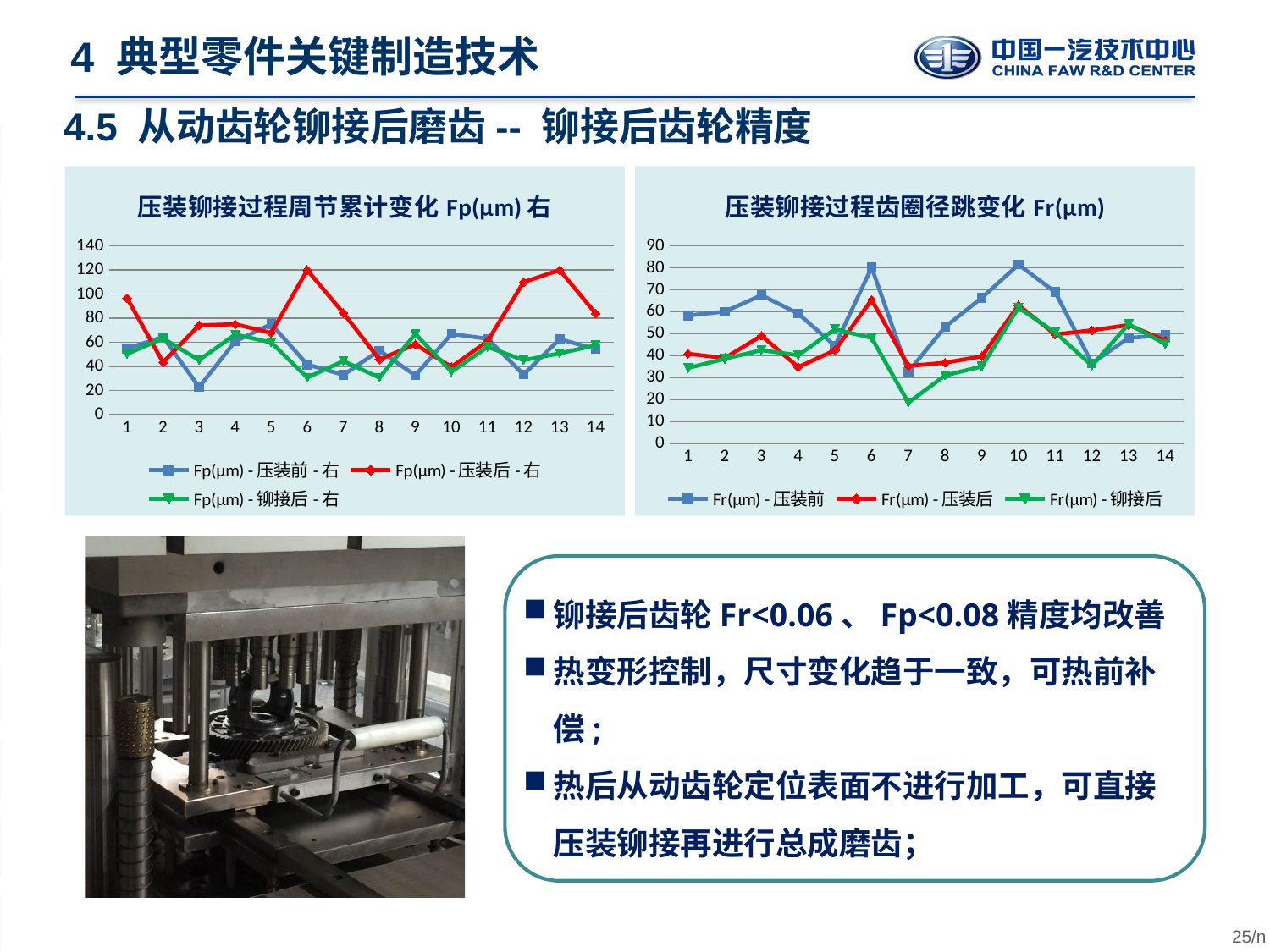
In the right chart (Fr(μm)), at point 10, which series is higher: Fr(μm) - 压装前 or Fr(μm) - 铆接后? Fr(μm) - 压装前 In the left chart (Fp(μm)), at point 6, which series is higher: Fp(μm) - 压装后 - 右 or Fp(μm) - 铆接后 - 右? Fp(μm) - 压装后 - 右 In the left chart (Fp(μm)), is the value of Fp(μm) - 压装前 - 右 at point 3 greater or less than 40? less In the left chart (Fp(μm)), at which point does the Fp(μm) - 压装前 - 右 series reach its lowest value? 3 What type of chart is the left chart titled 压装铆接过程周节累计变化 Fp(μm) 右? line chart What colour is the line for the 铆接后 series in the right chart (Fr(μm))? green In the left chart (Fp(μm)), is the value of Fp(μm) - 压装后 - 右 at point 6 greater or less than 100? greater In the right chart (Fr(μm)), is the value of Fr(μm) - 压装前 at point 10 greater or less than 70? greater How many points are plotted along the x axis of the left chart (Fp(μm))? 14 In the right chart (Fr(μm)), at which point does the Fr(μm) - 铆接后 series reach its lowest value? 7 How many series does the legend of the right chart (压装铆接过程齿圈径跳变化 Fr(μm)) list? 3